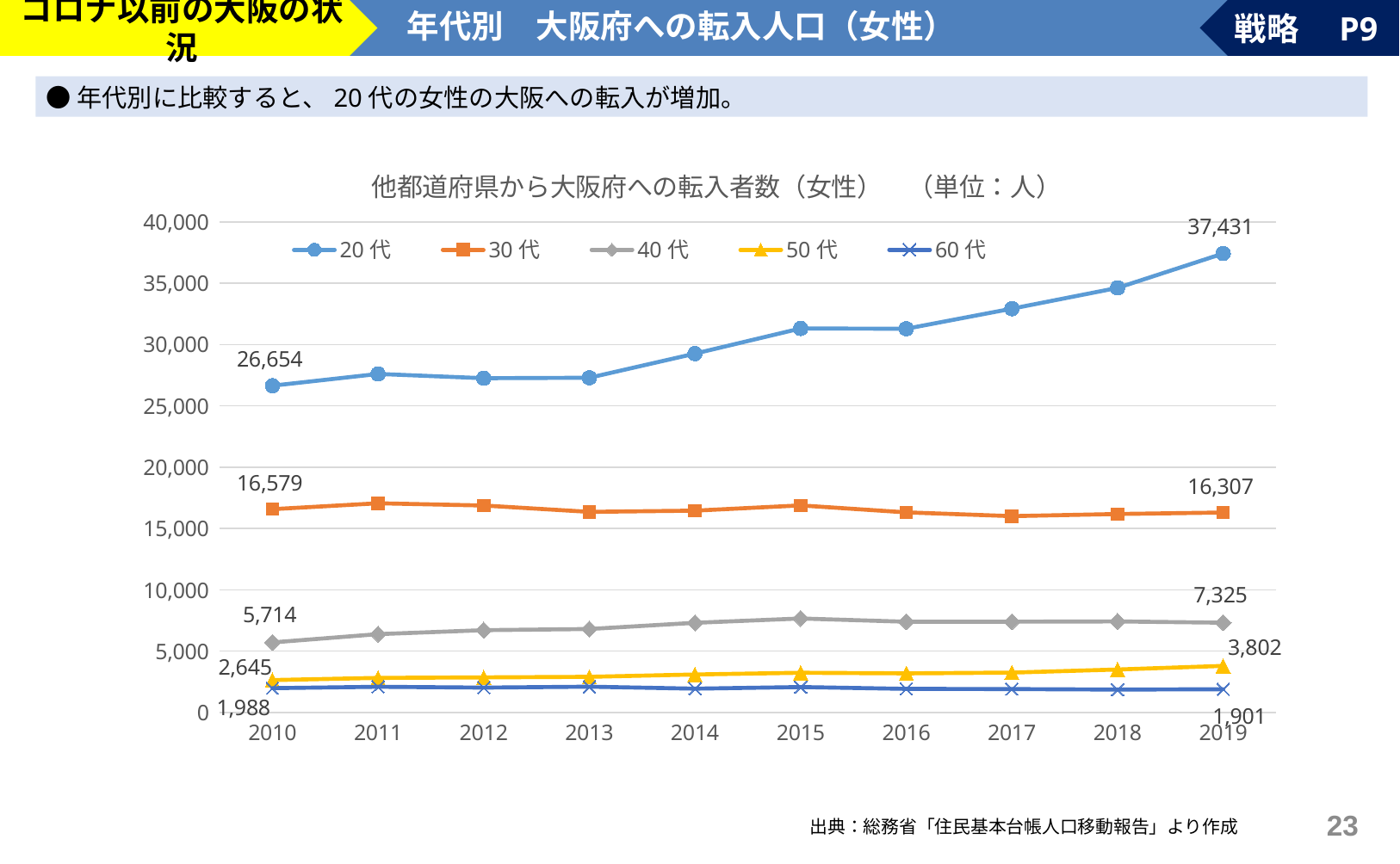
By how much did the value for 20代 increase from 2010 to 2019? 10,777 What is the value for 60代 in 2019? 1,901 What type of chart is shown on the slide? line chart Which series has the highest value in 2019? 20代 What is the value for 20代 in 2010? 26,654 What is the difference between the 40代 value in 2019 and in 2010? 1,611 What is the value for 30代 in 2010? 16,579 How many years are shown on the x axis? 10 Does the value for 20代 rise or fall from 2013 to 2019? rise How many series does the legend list? 5 What is the value for 20代 in 2019? 37,431 Which series has the lowest value in 2010? 60代